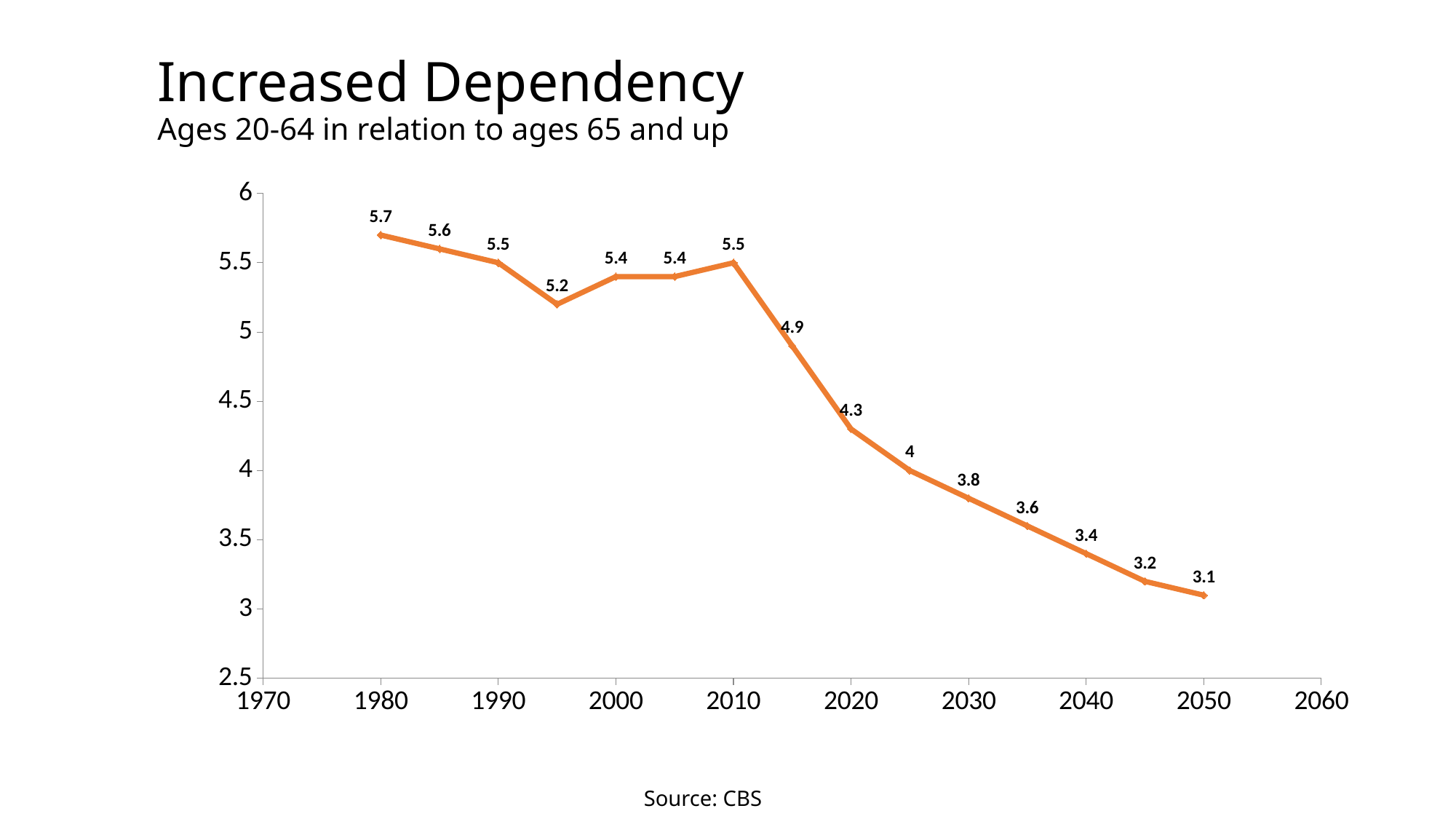
Which year has the highest value? 1980 Is the value for 2040 greater or less than 3.5? less Do the values generally rise or fall from 2010 to 2050? fall Which is larger, the value for 2000 or the value for 2030? 2000 What is the value for 1980? 5.7 Which year has the lowest value? 2050 What is the value for 2020? 4.3 What is the value for 2010? 5.5 What kind of chart is shown on the slide? line chart How many data points are plotted on the line? 15 What is the difference between the values for 1980 and 2050? 2.6 What is the value for 2050? 3.1